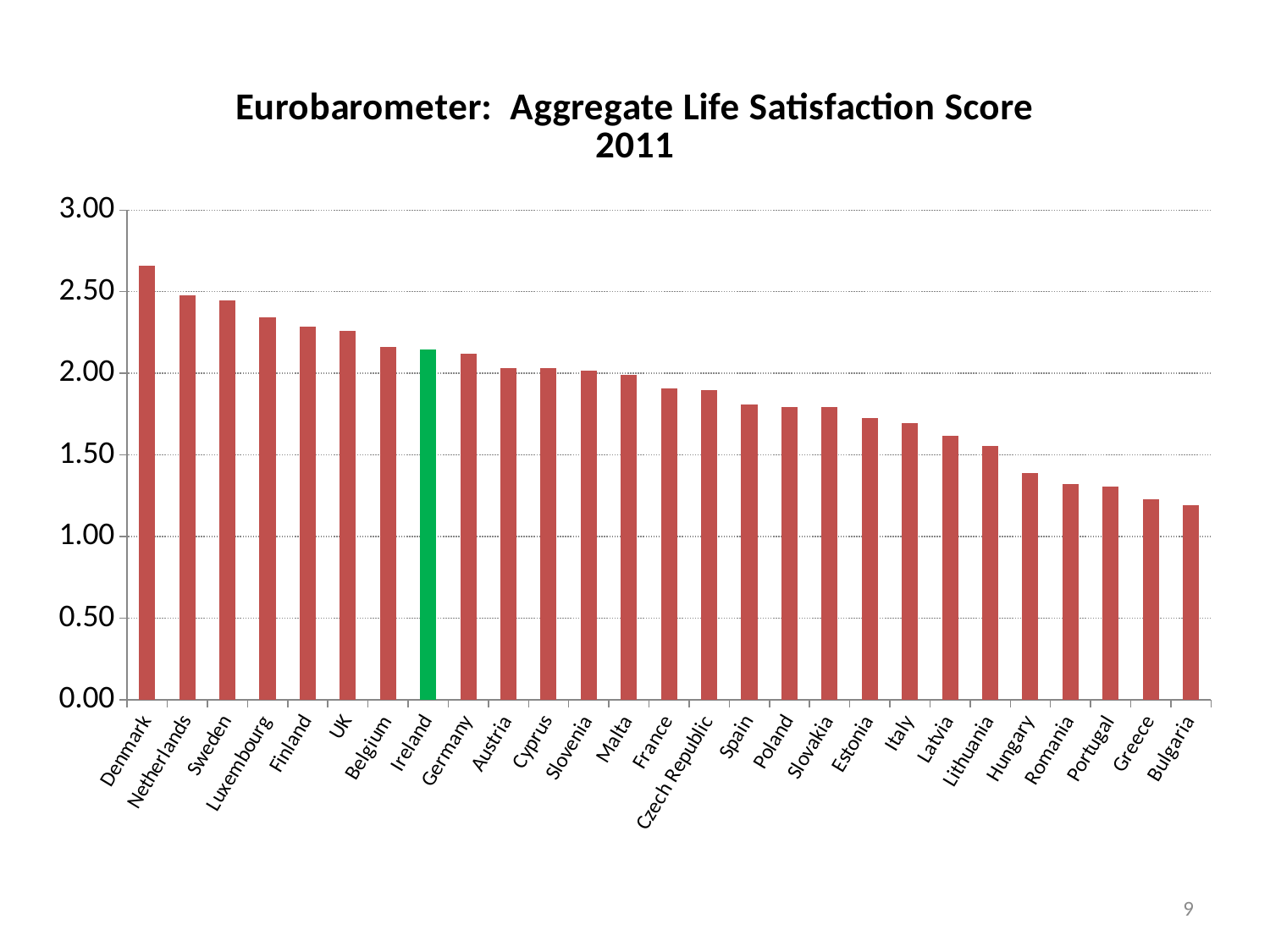
Which country has the highest aggregate life satisfaction score? Denmark Which country's bar is coloured green rather than red? Ireland Which has a higher score, Sweden or Spain? Sweden Is the value for Bulgaria greater or less than 1.50? less Is the value for Italy greater or less than 1.50? greater Is the value for Denmark greater or less than 2.50? greater Which country has the lowest aggregate life satisfaction score? Bulgaria How many countries are shown on the chart? 27 What kind of chart is shown on the slide? bar chart Do the scores rise or fall moving from left to right across the chart? fall